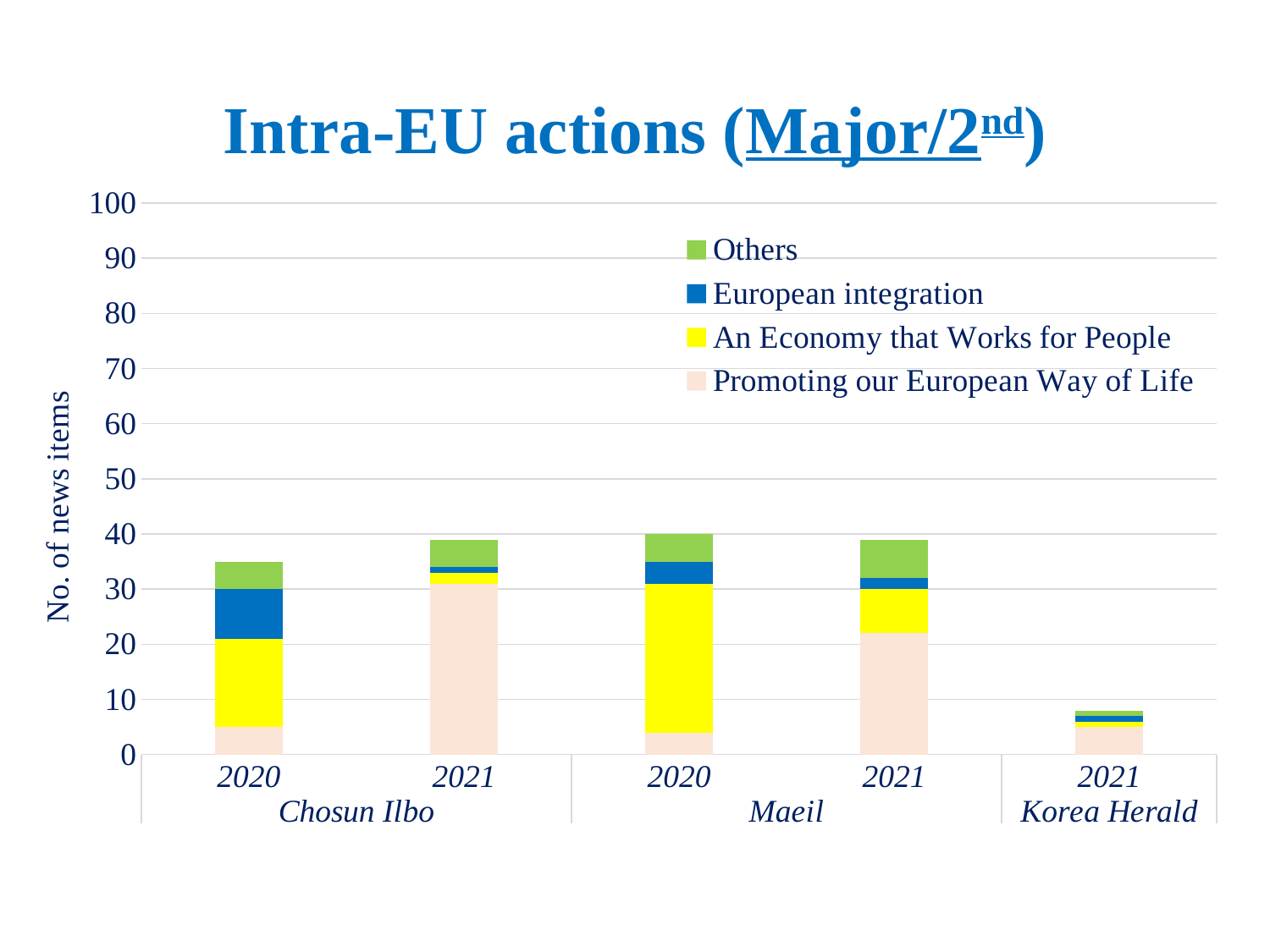
Which bar is taller: Chosun Ilbo 2020 or Korea Herald 2021? Chosun Ilbo 2020 How many series does the legend list? 4 Is the total for Chosun Ilbo 2020 greater or less than 30? greater Which bar is taller: Chosun Ilbo 2020 or Chosun Ilbo 2021? Chosun Ilbo 2021 Is the total for Maeil 2021 greater or less than 30? greater What is the label on the vertical axis? No. of news items Which bar has the lowest total number of news items? Korea Herald 2021 What kind of chart is shown on the slide? Stacked bar chart For Chosun Ilbo, does the total number of news items rise or fall from 2020 to 2021? rise Which series makes up the largest part of the Maeil 2020 bar? An Economy that Works for People How many bars are plotted in the chart? 5 Is the total for Korea Herald 2021 greater or less than 10? less